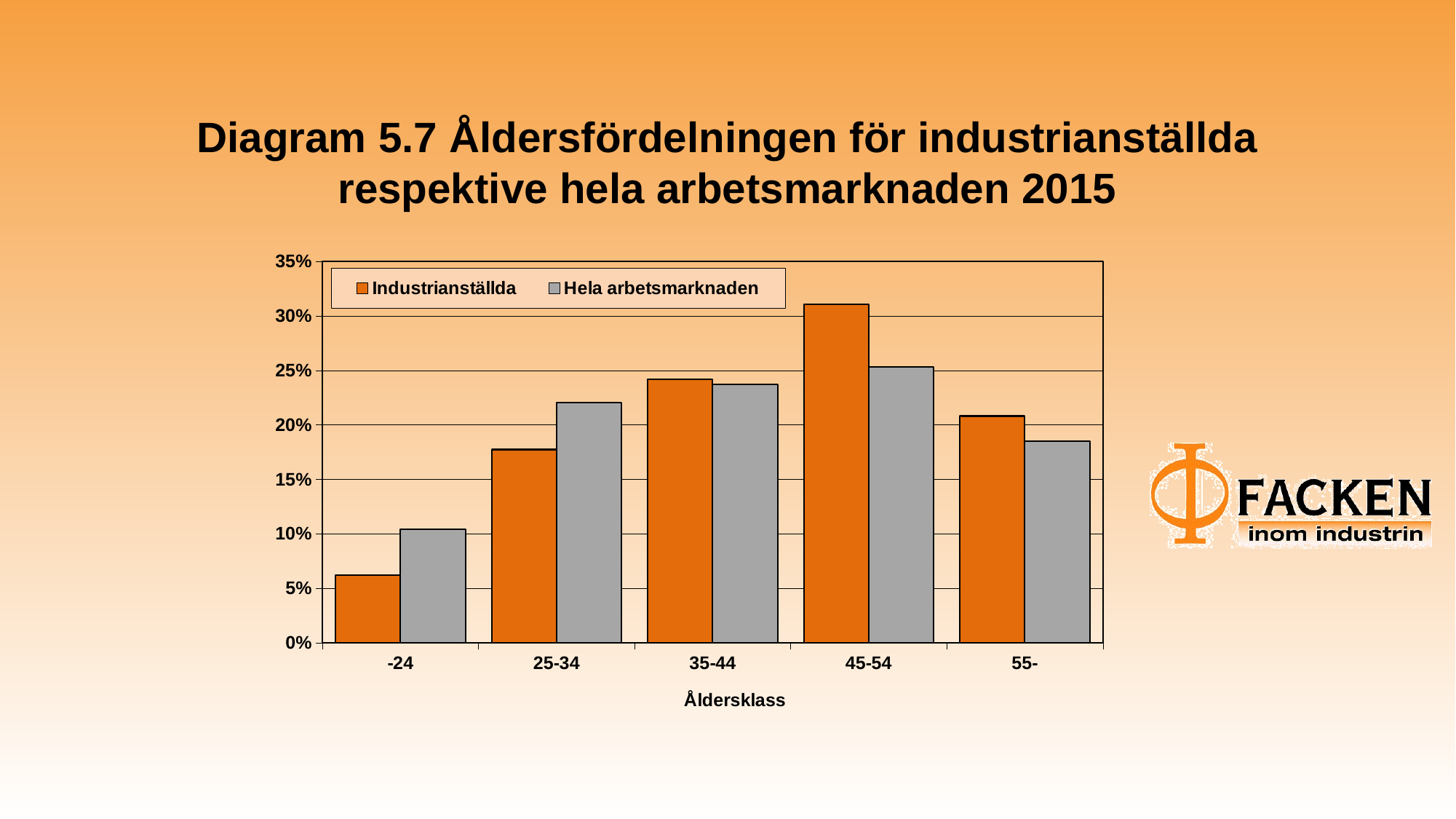
In the 45-54 age class, which series has the larger value, Industrianställda or Hela arbetsmarknaden? Industrianställda Is the value for Hela arbetsmarknaden in the 25-34 age class greater or less than 20%? greater Is the value for Industrianställda in the -24 age class greater or less than 10%? less How many age classes are shown on the x axis? 5 How many series does the legend list? 2 Is the value for Industrianställda in the 45-54 age class greater or less than 30%? greater What kind of chart is shown on the slide? bar chart Which age class has the lowest value for Hela arbetsmarknaden? -24 Which age class has the highest value for Industrianställda? 45-54 In the 25-34 age class, which series has the larger value, Industrianställda or Hela arbetsmarknaden? Hela arbetsmarknaden What is the label of the x axis? Åldersklass